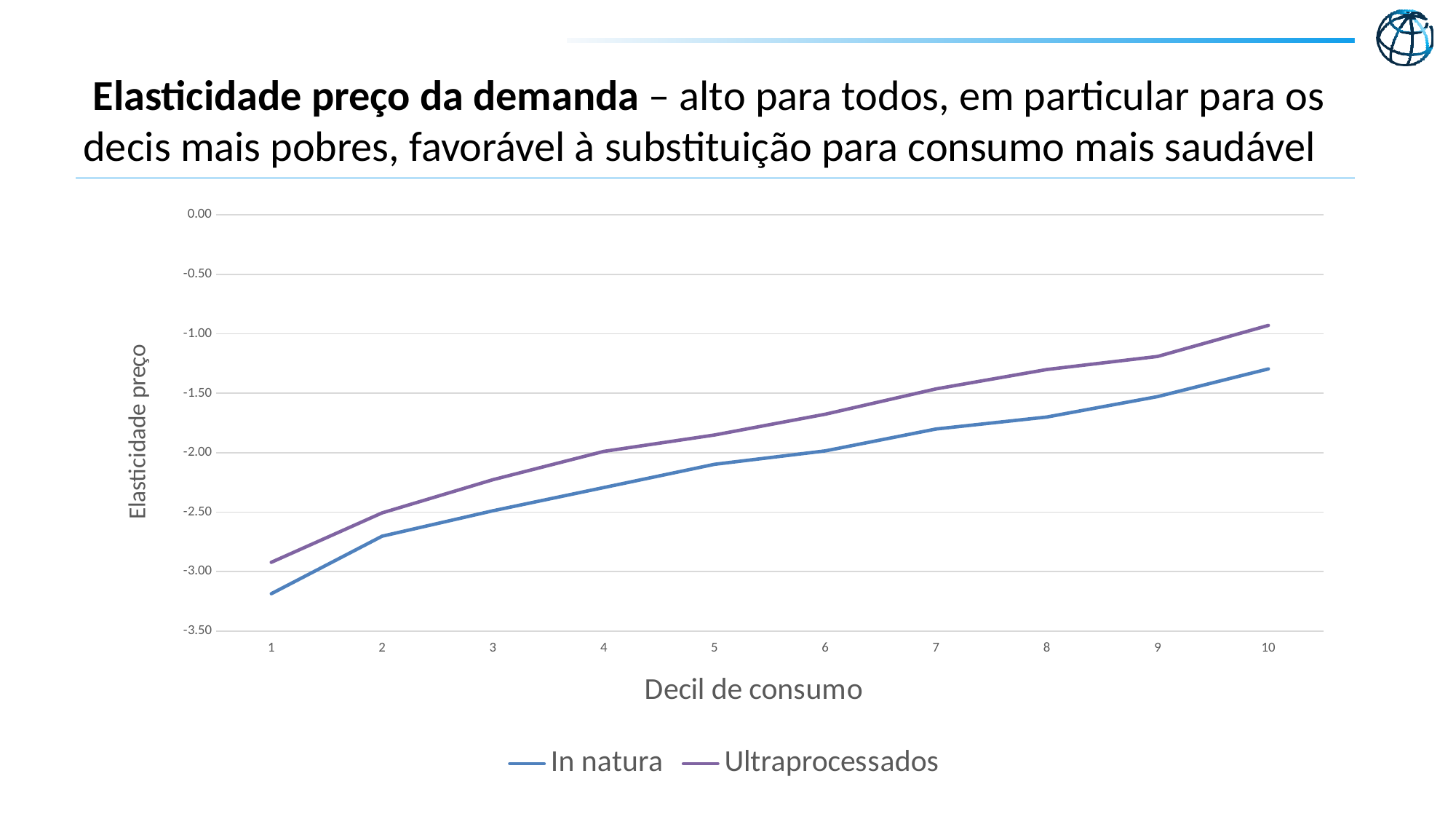
At decile 5, which series has the higher value, In natura or Ultraprocessados? Ultraprocessados How many series does the legend list? 2 For which decile is the Ultraprocessados value highest? 10 Is the In natura value at decile 4 greater or less than -2.00? less What kind of chart is shown on the slide? Line chart For which decile is the In natura value lowest? 1 What is the title of the x axis of the chart? Decil de consumo Do the values for In natura rise or fall as the consumption decile increases from 1 to 10? Rise Is the Ultraprocessados value at decile 10 greater or less than -1.00? greater Is the Ultraprocessados value at decile 8 greater or less than -1.50? greater How many consumption deciles are plotted along the x axis? 10